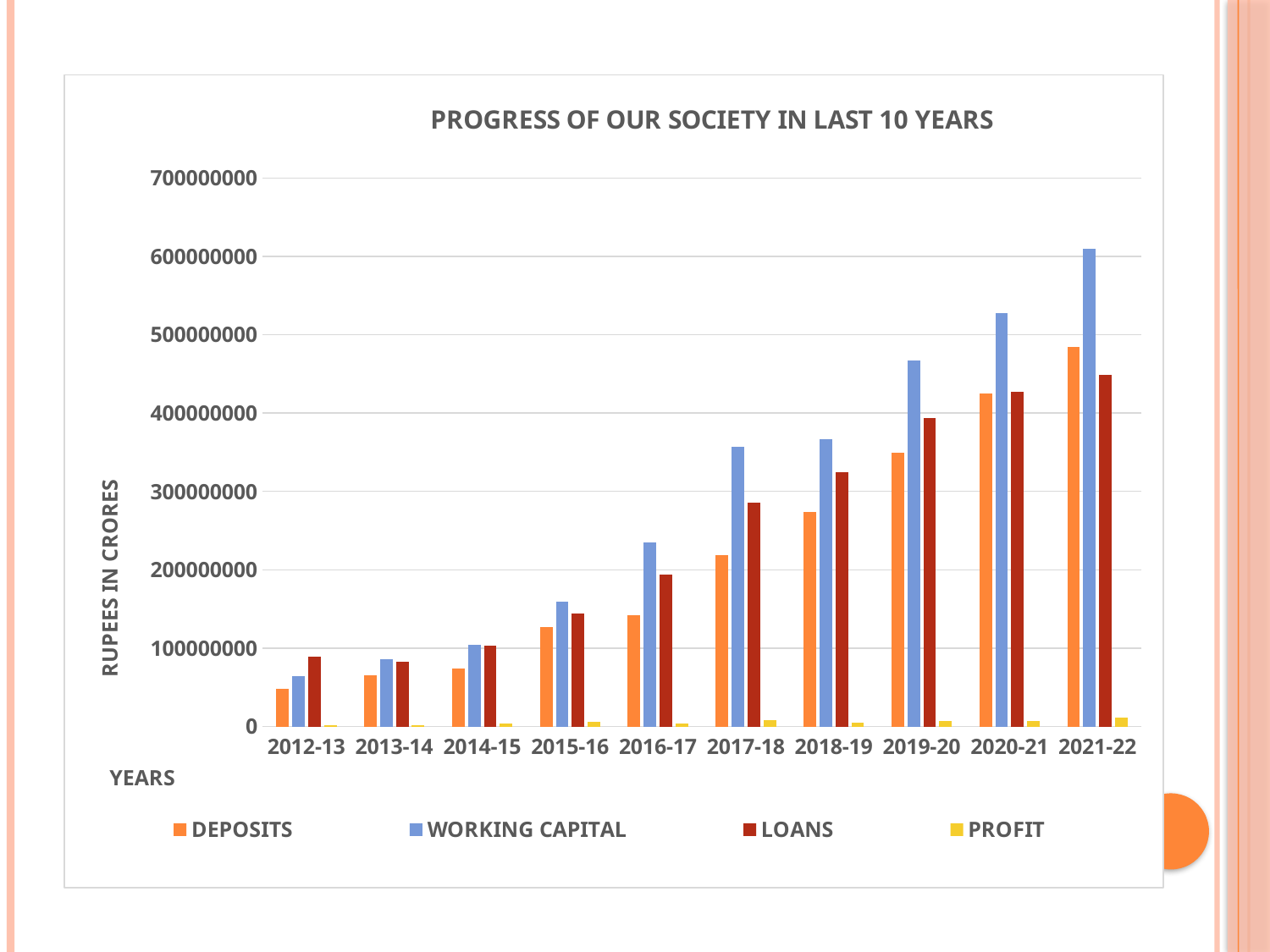
How many years are shown on the x axis? 10 What is the label on the vertical axis? RUPEES IN CRORES What is the title of the chart? PROGRESS OF OUR SOCIETY IN LAST 10 YEARS Which series has the lowest value in 2021-22? PROFIT In which year is WORKING CAPITAL the highest? 2021-22 Is the DEPOSITS value for 2021-22 greater or less than 500000000? less What kind of chart is shown on the slide? Bar chart Is the WORKING CAPITAL value for 2021-22 greater or less than 600000000? greater How many series does the legend list? 4 Does WORKING CAPITAL generally rise or fall from 2012-13 to 2021-22? Rise Is the LOANS value for 2017-18 greater or less than 300000000? less In 2012-13, which is larger: DEPOSITS or LOANS? LOANS